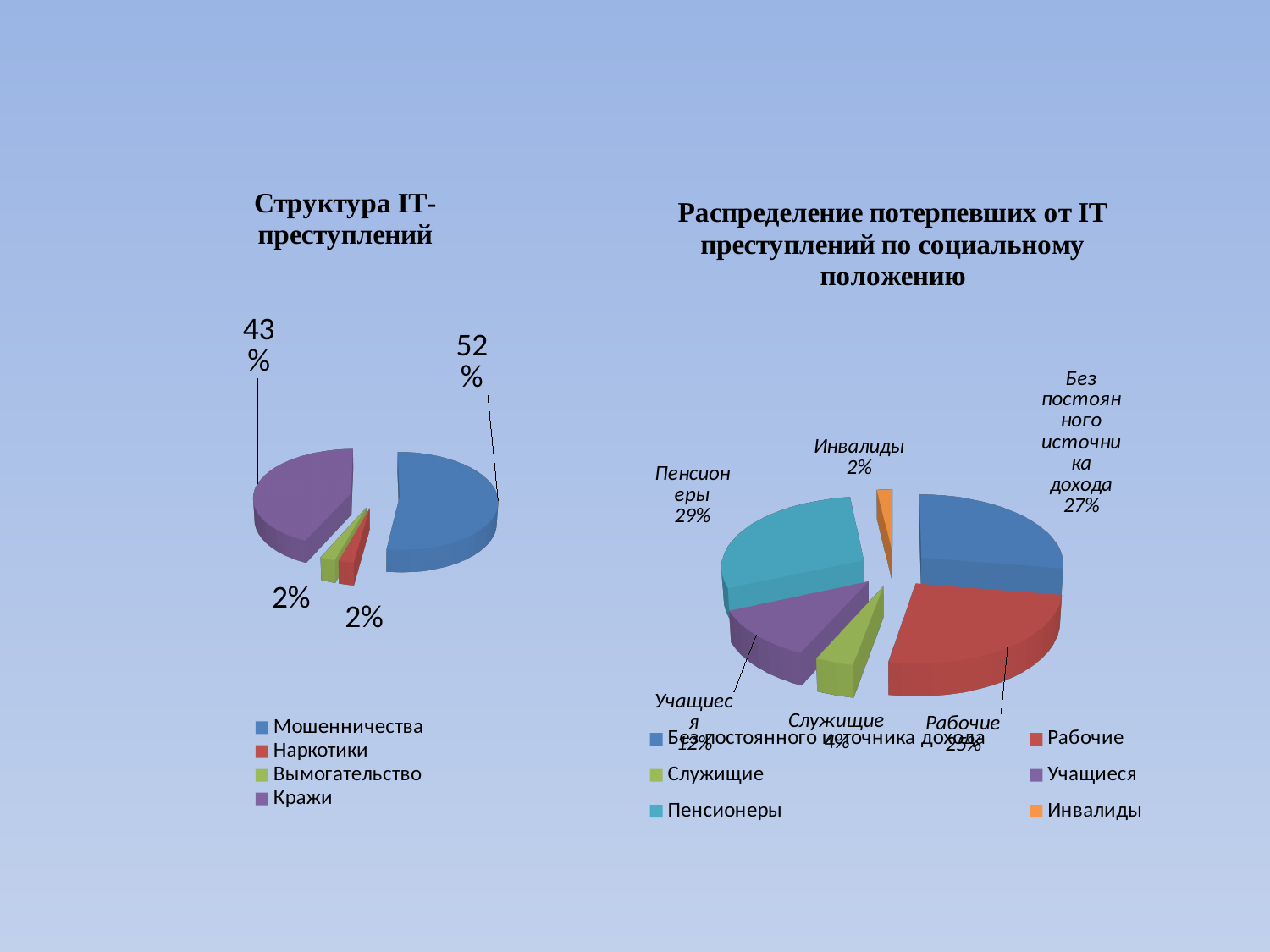
On the right-hand chart about the distribution of victims by social status, which is larger: Учащиеся or Служищие? Учащиеся On the right-hand chart about the distribution of victims by social status, how many categories does the legend list? 6 What kind of chart is the chart titled 'Структура IT-преступлений'? Pie chart On the chart titled 'Структура IT-преступлений', how many categories does the legend list? 4 On the chart titled 'Структура IT-преступлений', what share of the pie is Кражи? 43% On the right-hand chart about the distribution of victims by social status, what share is Без постоянного источника дохода? 27% On the right-hand chart about the distribution of victims by social status, which category has the smallest share? Инвалиды On the chart titled 'Структура IT-преступлений', what is the difference between the shares of Мошенничества and Кражи? 9% On the right-hand chart about the distribution of victims by social status, what share is Инвалиды? 2% On the chart titled 'Структура IT-преступлений', what share of the pie is Мошенничества? 52% On the chart titled 'Структура IT-преступлений', which category has the largest share? Мошенничества On the right-hand chart about the distribution of victims by social status, what share is Пенсионеры? 29%